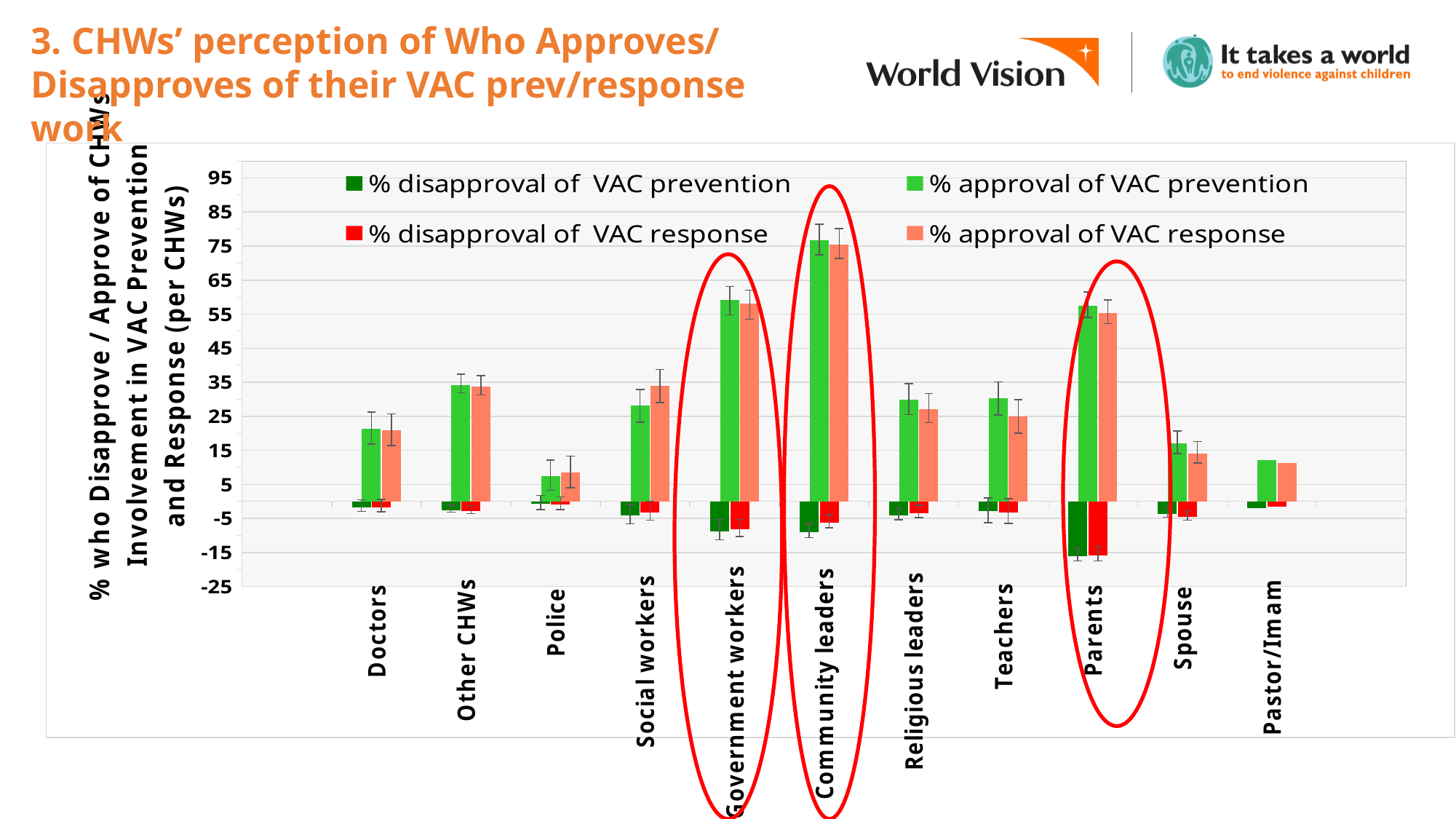
How many series does the chart's legend list? 4 Which is larger: the % approval of VAC response for Other CHWs or for Spouse? Other CHWs How many categories are shown along the x axis of the chart? 11 Is the value for Government workers in the % approval of VAC prevention series greater or less than 55? greater Which category has the lowest value for % approval of VAC prevention? Police Is the value for Community leaders in the % approval of VAC prevention series greater or less than 65? greater Which category has the lowest (most negative) value for % disapproval of VAC prevention? Parents Which category has the highest value for % approval of VAC prevention? Community leaders Is the value for Parents in the % disapproval of VAC response series greater or less than -5? less What kind of chart is shown on the slide? bar chart Which colour represents the % disapproval of VAC response series in the legend? red Which is larger: the % approval of VAC prevention for Government workers or for Teachers? Government workers